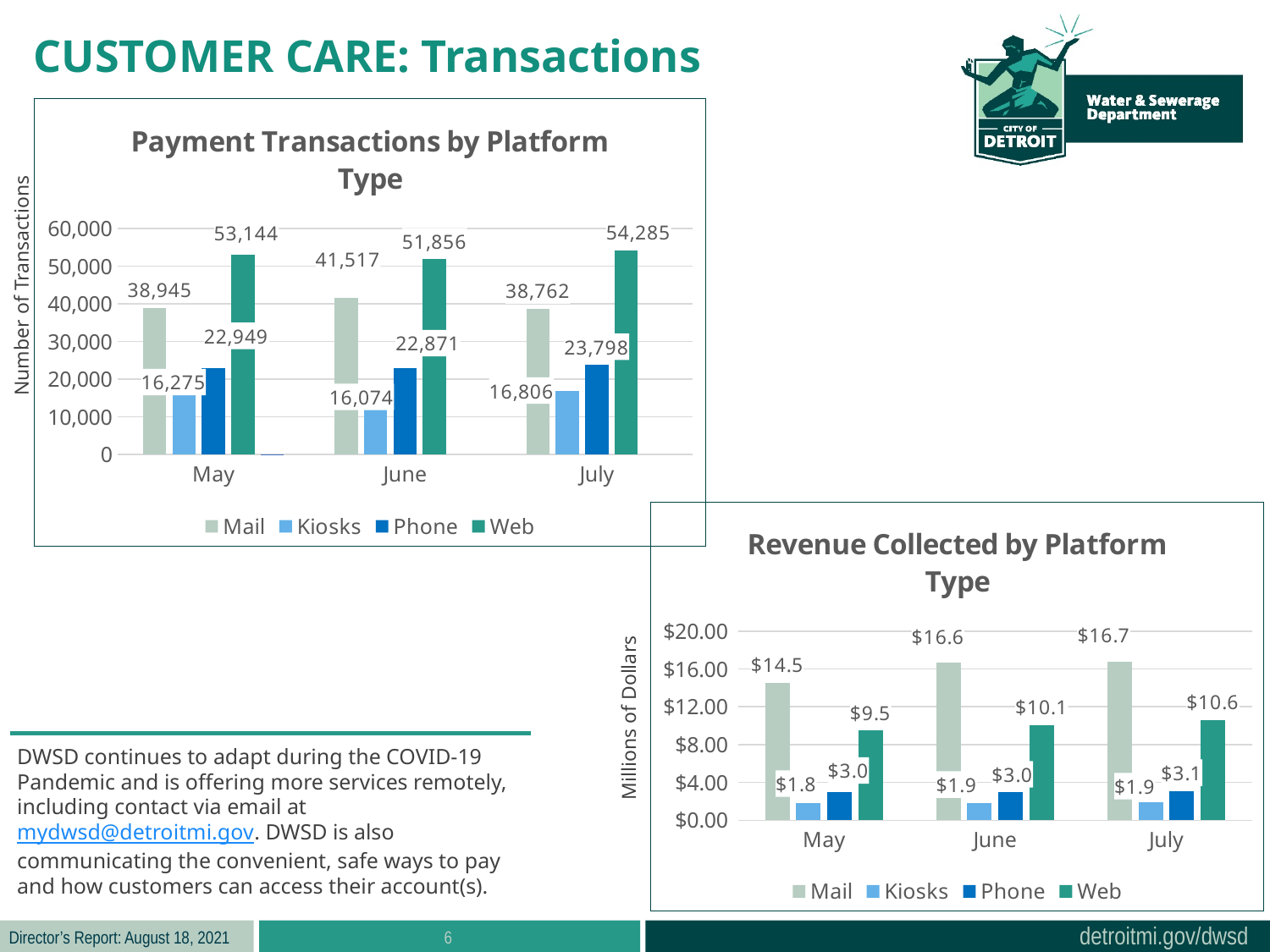
In the 'Revenue Collected by Platform Type' chart, which is larger: Web revenue in June or Web revenue in July? July In the 'Revenue Collected by Platform Type' chart, which platform collected the least revenue in June? Kiosks What type of chart is 'Revenue Collected by Platform Type'? bar chart In the 'Payment Transactions by Platform Type' chart, how many Web transactions were there in July? 54,285 In the 'Revenue Collected by Platform Type' chart, how much revenue was collected via Kiosks in May? $1.8 In the 'Payment Transactions by Platform Type' chart, do Phone transactions rise or fall from June to July? rise In the 'Payment Transactions by Platform Type' chart, which month had the highest number of Mail transactions? June In the 'Payment Transactions by Platform Type' chart, how many series does the legend list? 4 In the 'Payment Transactions by Platform Type' chart, what is the difference between Web and Mail transactions in May? 14,199 In the 'Revenue Collected by Platform Type' chart, how much revenue was collected via Web in July? $10.6 In the 'Revenue Collected by Platform Type' chart, is Mail revenue in May greater or less than $12.00? greater In the 'Payment Transactions by Platform Type' chart, how many Kiosks transactions were there in June? 16,074